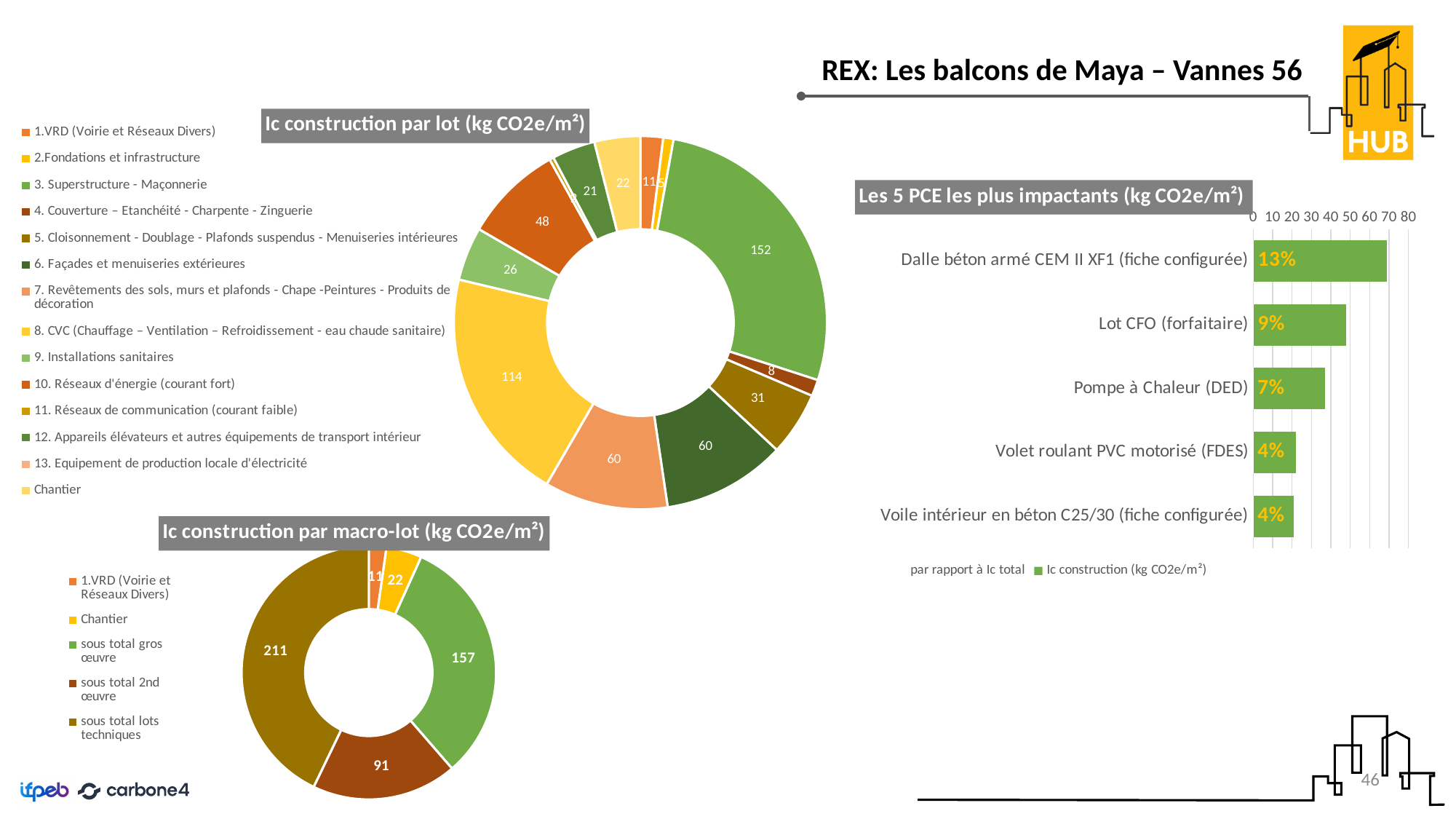
In the 'Ic construction par macro-lot (kg CO2e/m²)' chart, which category has the highest value? sous total lots techniques In the 'Les 5 PCE les plus impactants (kg CO2e/m²)' chart, what percentage is shown for 'Dalle béton armé CEM II XF1 (fiche configurée)'? 13% In the 'Ic construction par lot (kg CO2e/m²)' chart, what is the value for '8. CVC (Chauffage – Ventilation – Refroidissement - eau chaude sanitaire)'? 114 In the 'Les 5 PCE les plus impactants (kg CO2e/m²)' chart, is the bar for 'Volet roulant PVC motorisé (FDES)' greater or less than 30? less In the 'Les 5 PCE les plus impactants (kg CO2e/m²)' chart, is the bar for 'Dalle béton armé CEM II XF1 (fiche configurée)' greater or less than 60? greater What kind of chart is 'Les 5 PCE les plus impactants (kg CO2e/m²)'? bar chart In the 'Ic construction par macro-lot (kg CO2e/m²)' chart, what is the value for 'sous total 2nd œuvre'? 91 In the 'Ic construction par lot (kg CO2e/m²)' chart, what is the value for '3. Superstructure - Maçonnerie'? 152 In the 'Ic construction par lot (kg CO2e/m²)' chart, which is larger: '6. Façades et menuiseries extérieures' or '5. Cloisonnement - Doublage - Plafonds suspendus - Menuiseries intérieures'? 6. Façades et menuiseries extérieures In the 'Ic construction par macro-lot (kg CO2e/m²)' chart, what is the difference between 'sous total lots techniques' and 'sous total gros œuvre'? 54 In the 'Ic construction par lot (kg CO2e/m²)' chart, which lot has the highest value? 3. Superstructure - Maçonnerie How many categories does the 'Ic construction par macro-lot (kg CO2e/m²)' chart show? 5